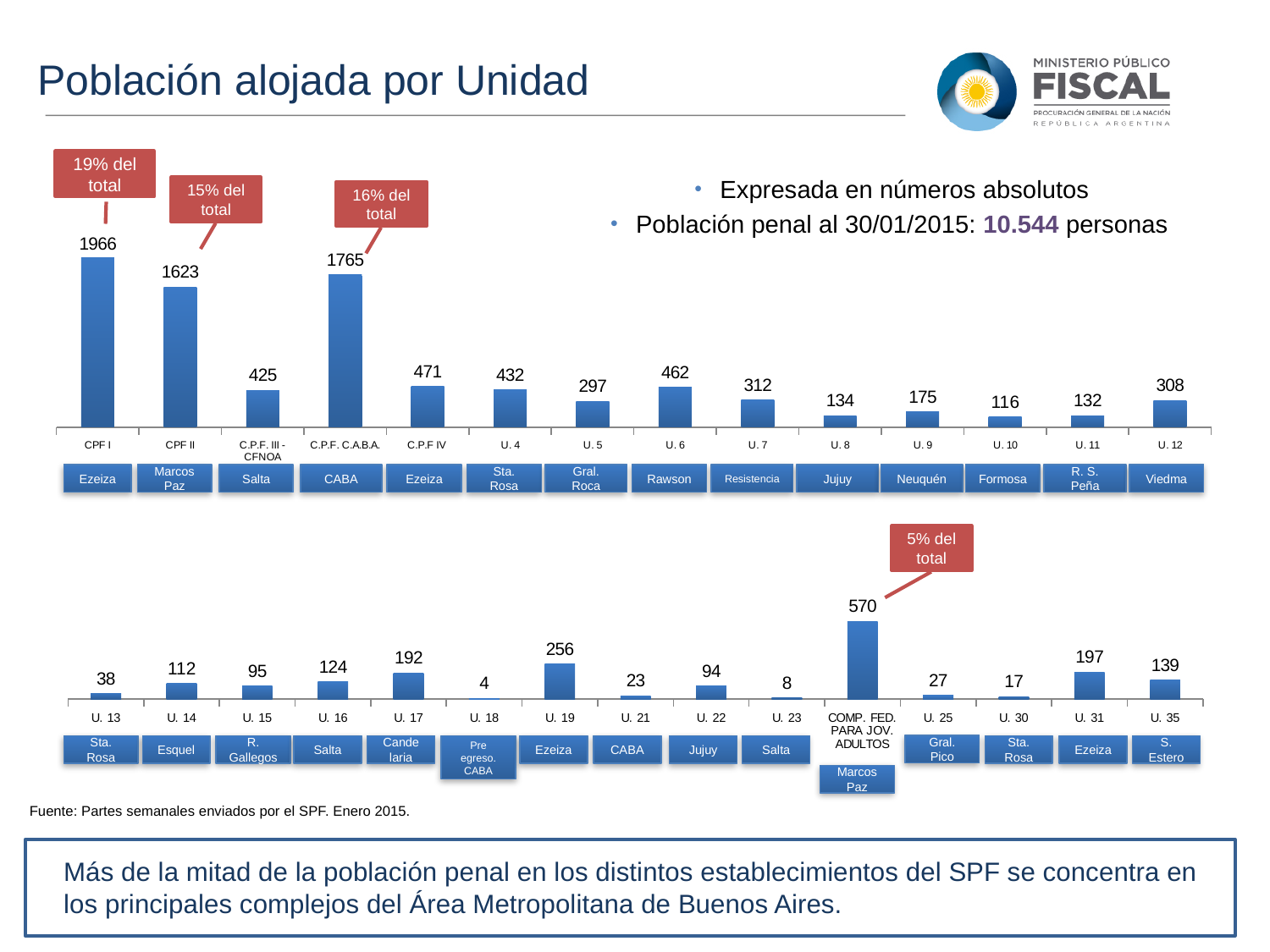
In the top chart, what is the value for C.P.F. C.A.B.A.? 1765 How many units are shown in the top chart? 14 In the top chart, what is the value for CPF I? 1966 In the top chart, which unit has the highest value? CPF I In the top chart, which is larger, U. 6 or U. 4? U. 6 In the top chart, which unit has the lowest value? U. 10 In the bottom chart, which unit has the lowest value? U. 18 What type of chart is the top chart? Bar chart How many units are shown in the bottom chart? 15 In the bottom chart, what is the value for COMP. FED. PARA JOV. ADULTOS? 570 In the bottom chart, what is the difference between U. 19 and U. 17? 64 In the top chart, what is the difference between CPF I and CPF II? 343